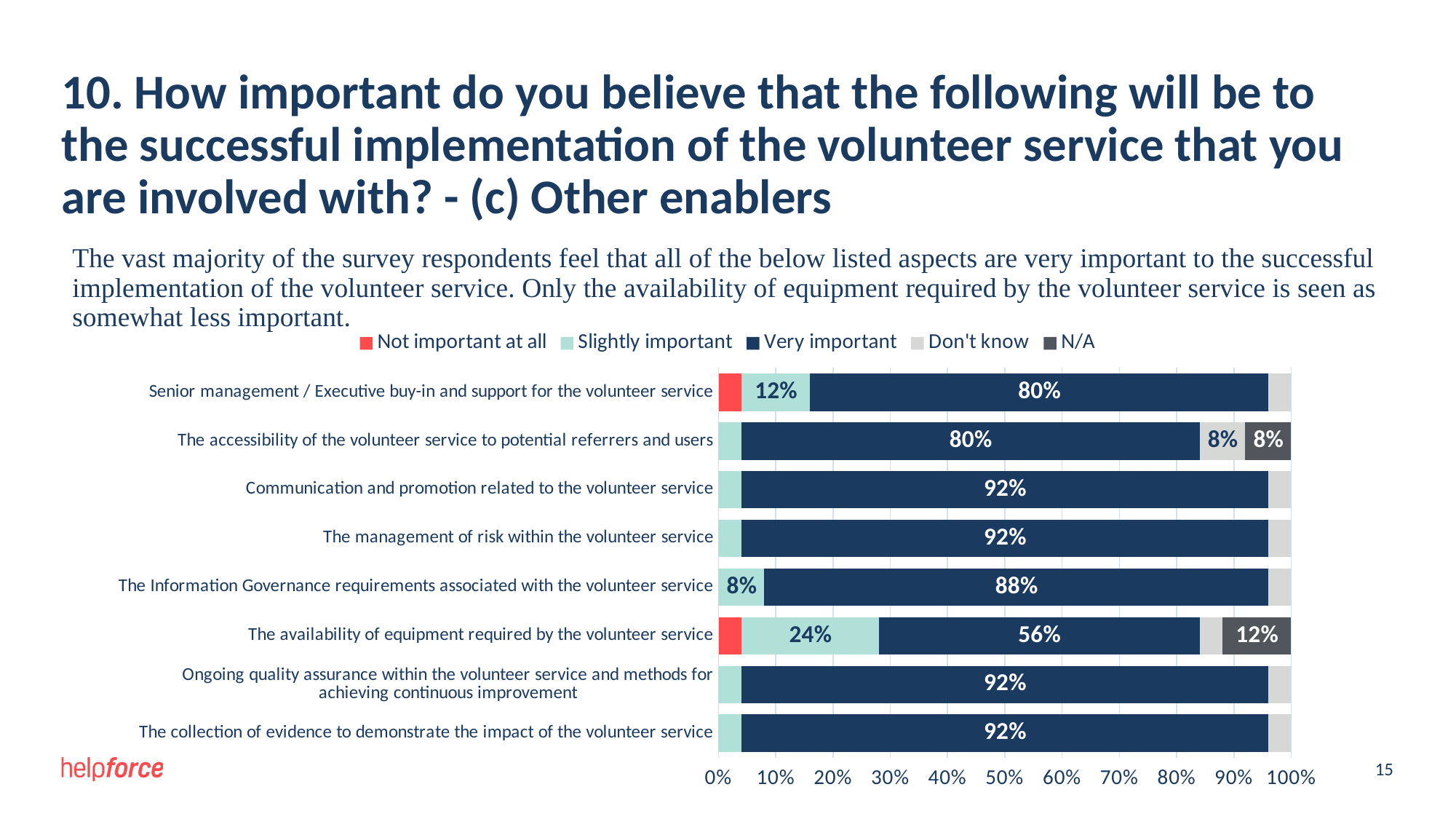
Which has a larger 'Very important' percentage: the management of risk within the volunteer service or the Information Governance requirements associated with the volunteer service? The management of risk within the volunteer service How many categories are shown in the chart? 8 What percentage of respondents rated senior management / executive buy-in and support for the volunteer service as very important? 80% What is the 'N/A' value for the accessibility of the volunteer service to potential referrers and users? 8% What is the 'Slightly important' value for the Information Governance requirements associated with the volunteer service? 8% What type of chart is shown on the slide? Stacked bar chart What is the 'Very important' value for the availability of equipment required by the volunteer service? 56% How many series does the legend list? 5 What percentage of respondents rated the availability of equipment required by the volunteer service as slightly important? 24% Which legend entry is shown in red? Not important at all What is the difference between the 'Very important' percentage for communication and promotion related to the volunteer service and that for the availability of equipment required by the volunteer service? 36% Which category has the lowest 'Very important' percentage? The availability of equipment required by the volunteer service